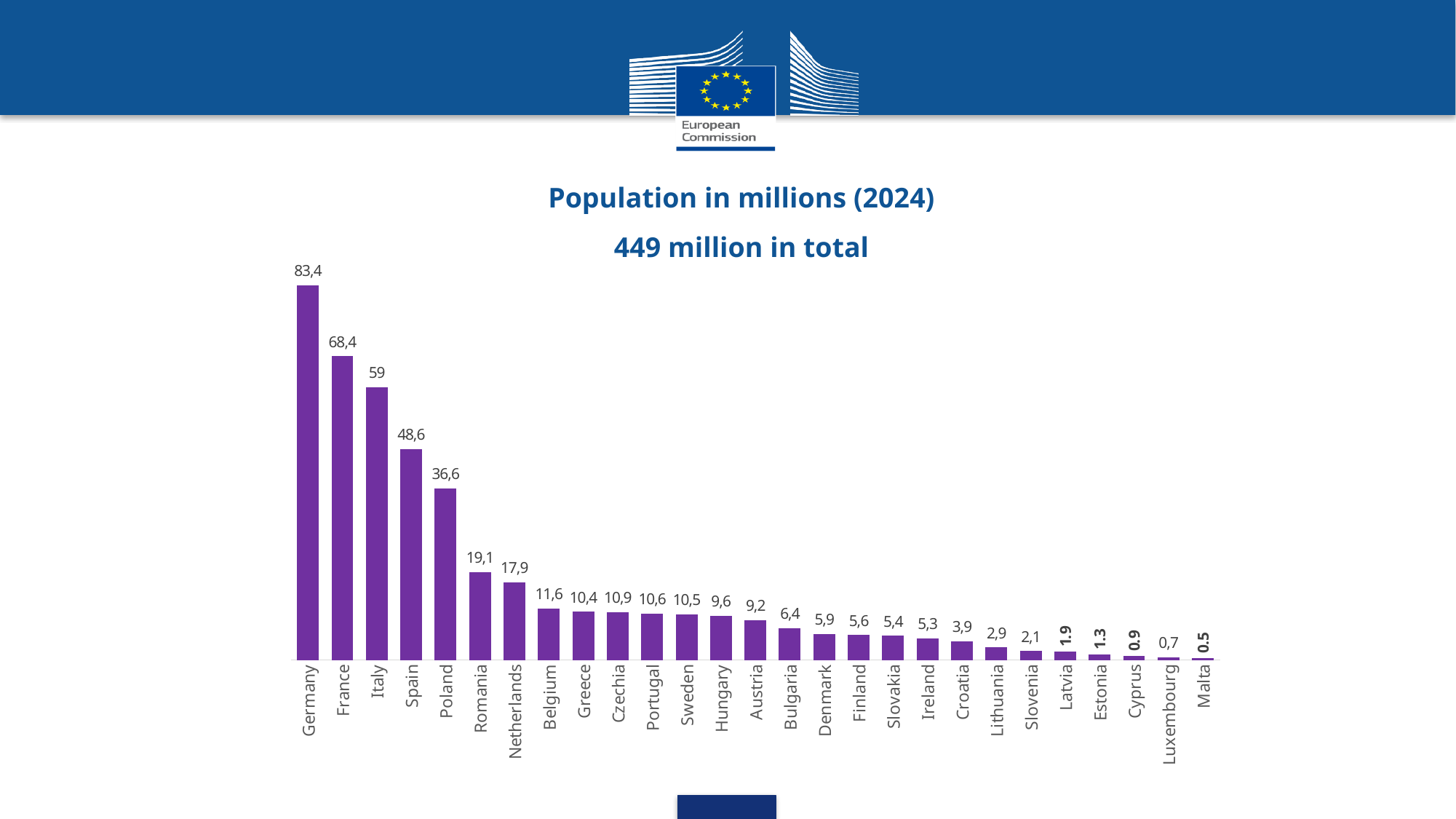
What is the difference between the values for Germany and France? 15 Which has a larger value, Czechia or Greece? Czechia What is the population value shown for Latvia? 1.9 What is the population value shown for Poland? 36,6 Which has a larger value, Romania or Netherlands? Romania What kind of chart is shown on the slide? Bar chart Which country has the highest bar in the chart? Germany Which country has the lowest bar in the chart? Malta What is the title of the chart? Population in millions (2024) 449 million in total What is the population value shown for Germany? 83,4 What is the difference between the values for Italy and Spain? 10,4 How many countries are shown in the chart? 27